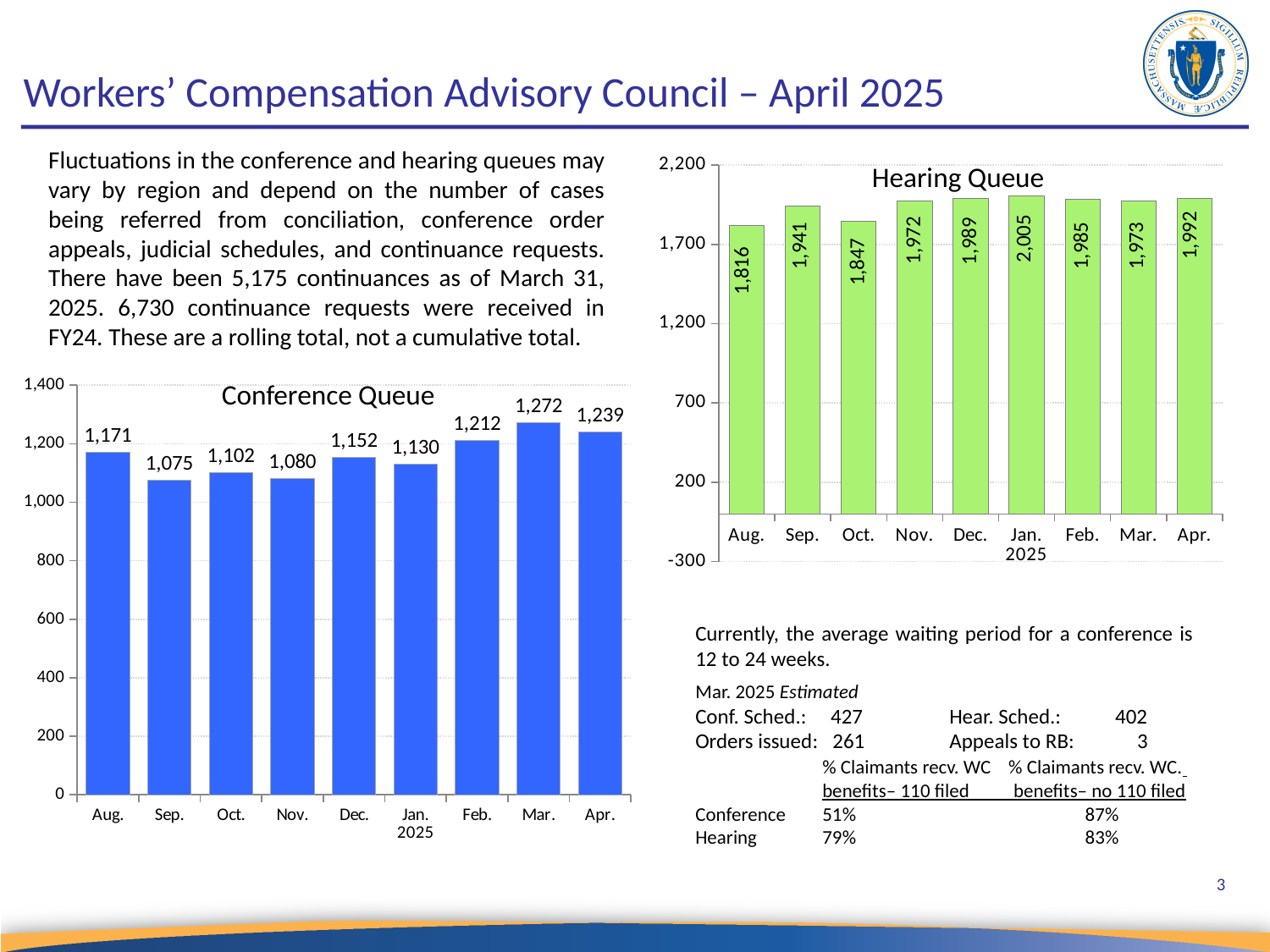
In the Conference Queue chart, which month has the lowest value? Sep. In the Conference Queue chart, what is the difference between the values for Mar. and Apr.? 33 In the Conference Queue chart, which is larger, the value for Dec. or the value for Feb.? Feb. In the Conference Queue chart, what is the value for Mar.? 1,272 In the Hearing Queue chart, which month has the lowest value? Aug. What colour are the bars in the Hearing Queue chart? Green In the Hearing Queue chart, what is the value for Jan. 2025? 2,005 In the Conference Queue chart, is the value for Aug. greater or less than 1,000? greater What type of chart is the Hearing Queue chart? Bar chart In the Hearing Queue chart, what is the difference between the values for Sep. and Aug.? 125 In the Hearing Queue chart, which month has the highest value? Jan. 2025 How many months are plotted in the Conference Queue chart? 9